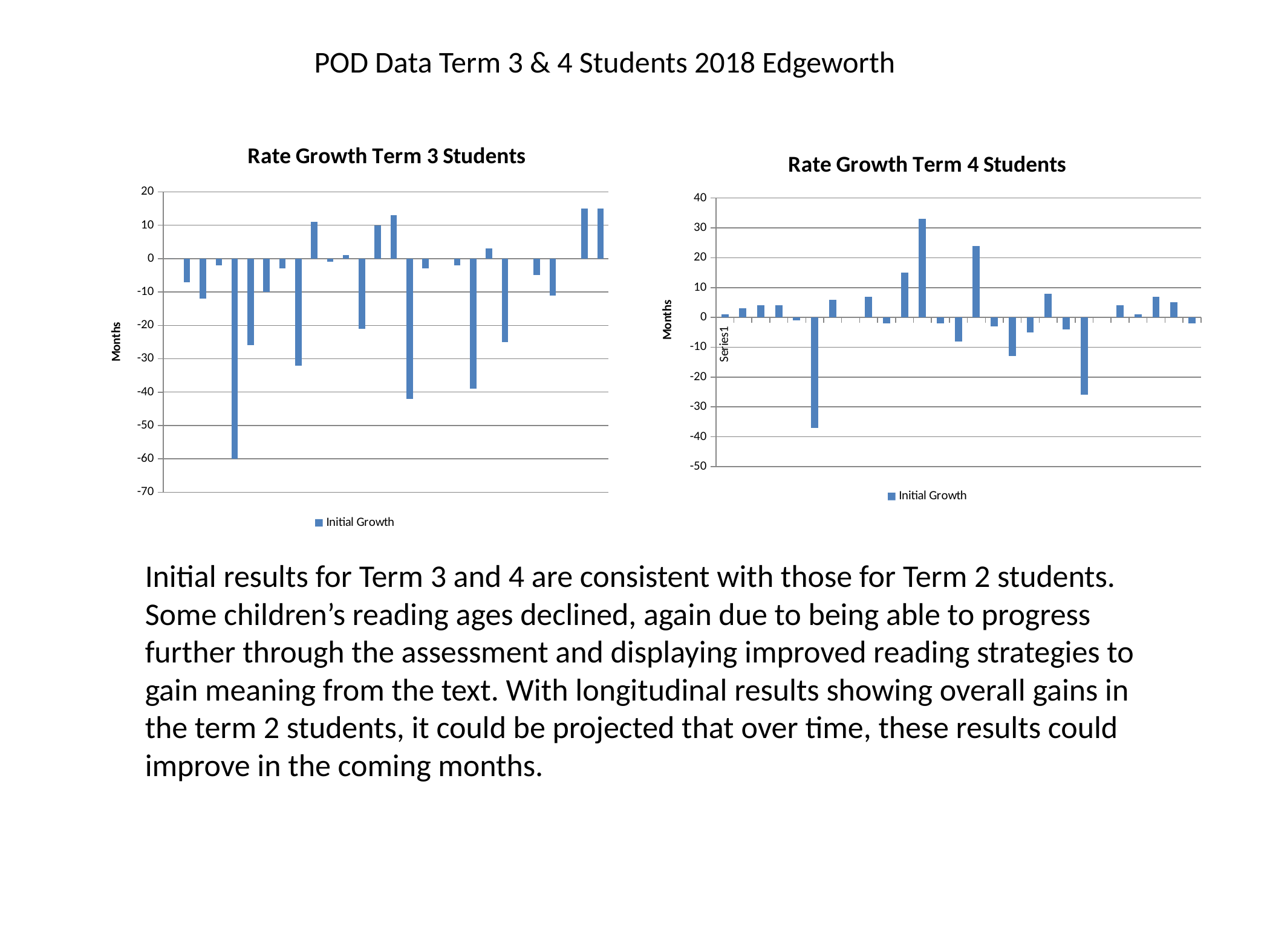
How many series does the legend of the 'Rate Growth Term 3 Students' chart list? 1 Which chart has the lower minimum value, 'Rate Growth Term 3 Students' or 'Rate Growth Term 4 Students'? Rate Growth Term 3 Students How many series does the legend of the 'Rate Growth Term 4 Students' chart list? 1 In the 'Rate Growth Term 3 Students' chart, is the lowest bar's value greater or less than -50? less In the 'Rate Growth Term 4 Students' chart, is the lowest bar's value greater or less than -30? less What is the name of the series shown in the legend of the 'Rate Growth Term 3 Students' chart? Initial Growth What kind of chart is the 'Rate Growth Term 4 Students' chart? bar chart In the 'Rate Growth Term 4 Students' chart, is the highest bar's value greater or less than 30? greater Which chart has the higher maximum value, 'Rate Growth Term 3 Students' or 'Rate Growth Term 4 Students'? Rate Growth Term 4 Students What is the label on the vertical axis of the 'Rate Growth Term 4 Students' chart? Months What kind of chart is the 'Rate Growth Term 3 Students' chart? bar chart